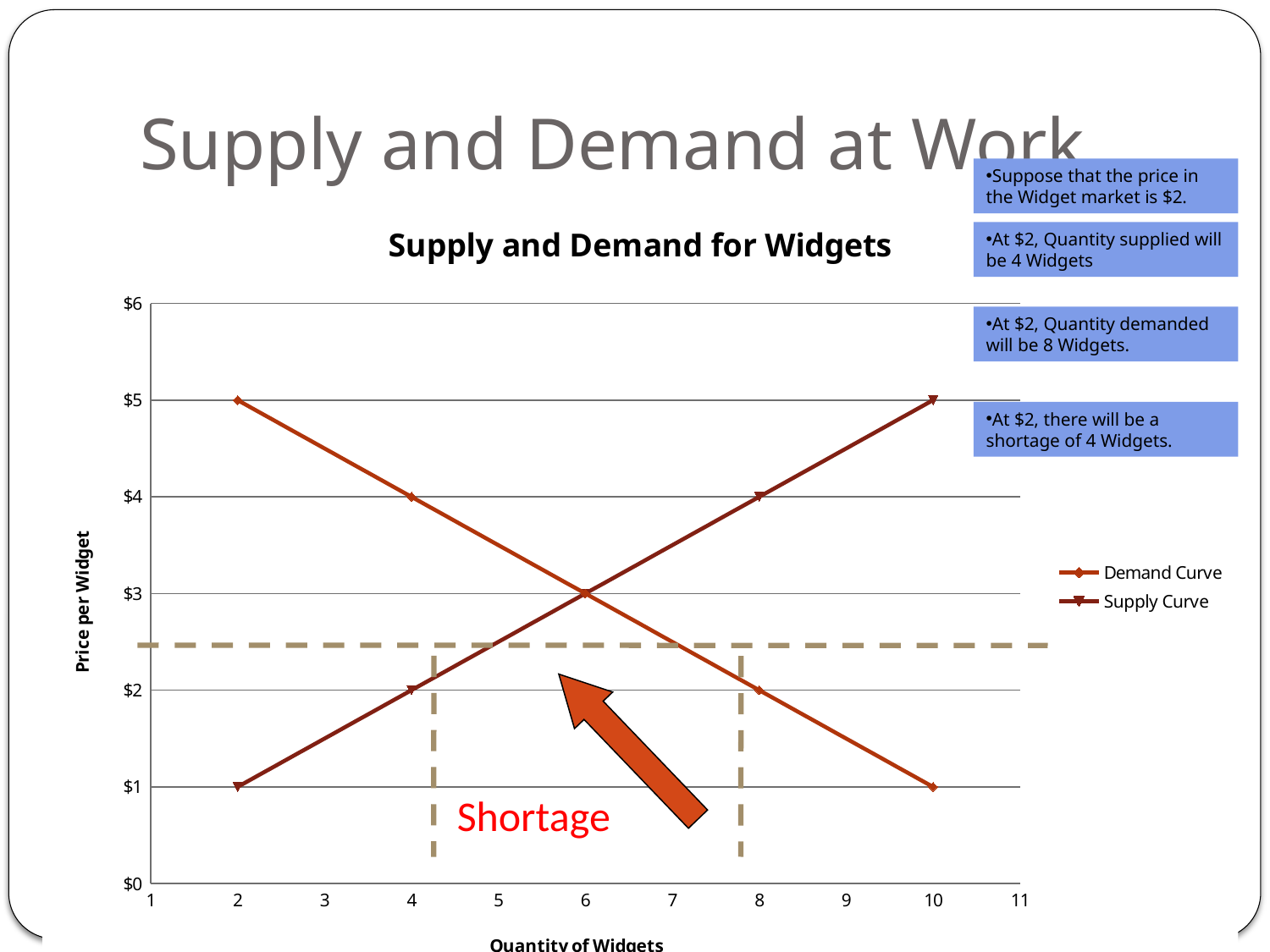
How many data points are plotted on the Demand Curve? 5 Does the Demand Curve rise or fall as quantity increases along the x axis? fall How many series does the legend list? 2 What is the title of the chart? Supply and Demand for Widgets Does the Supply Curve rise or fall as quantity increases along the x axis? rise What type of chart is shown on the slide? line chart At what price do the Demand Curve and Supply Curve intersect? $3 What is the price per widget on the Supply Curve at a quantity of 2? $1 What is the price per widget on the Demand Curve at a quantity of 2? $5 What are the two series named in the legend? Demand Curve and Supply Curve At a quantity of 8, which curve shows the higher price, the Demand Curve or the Supply Curve? Supply Curve At what quantity of widgets do the Demand Curve and Supply Curve intersect? 6